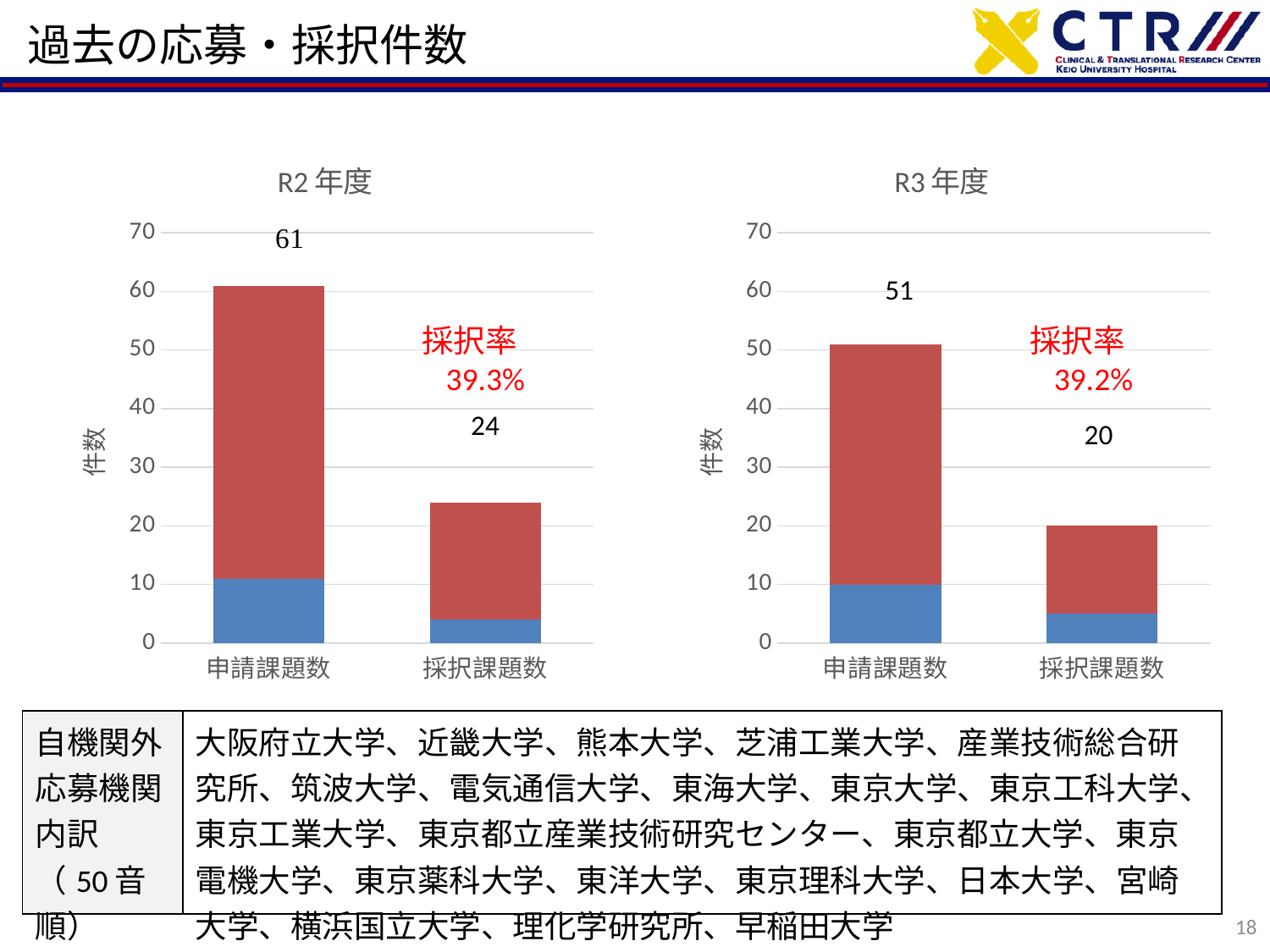
In the R2年度 chart, what is the value labelled for 申請課題数? 61 Which chart shows the larger value for 申請課題数, R2年度 or R3年度? R2年度 How many categories are shown on the x axis of the R3年度 chart? 2 In the R3年度 chart, what is the difference between 申請課題数 and 採択課題数? 31 In the R2年度 chart, what is the value labelled for 採択課題数? 24 In the R2年度 chart, what is the difference between 申請課題数 and 採択課題数? 37 In the R3年度 chart, what is the value labelled for 採択課題数? 20 What kind of chart is the R2年度 chart? bar chart In the R3年度 chart, what is the value labelled for 申請課題数? 51 In the R2年度 chart, is the blue portion of the 申請課題数 bar greater or less than 20? less What is the y-axis title of the R2年度 chart? 件数 In the R3年度 chart, which category has the lowest value? 採択課題数